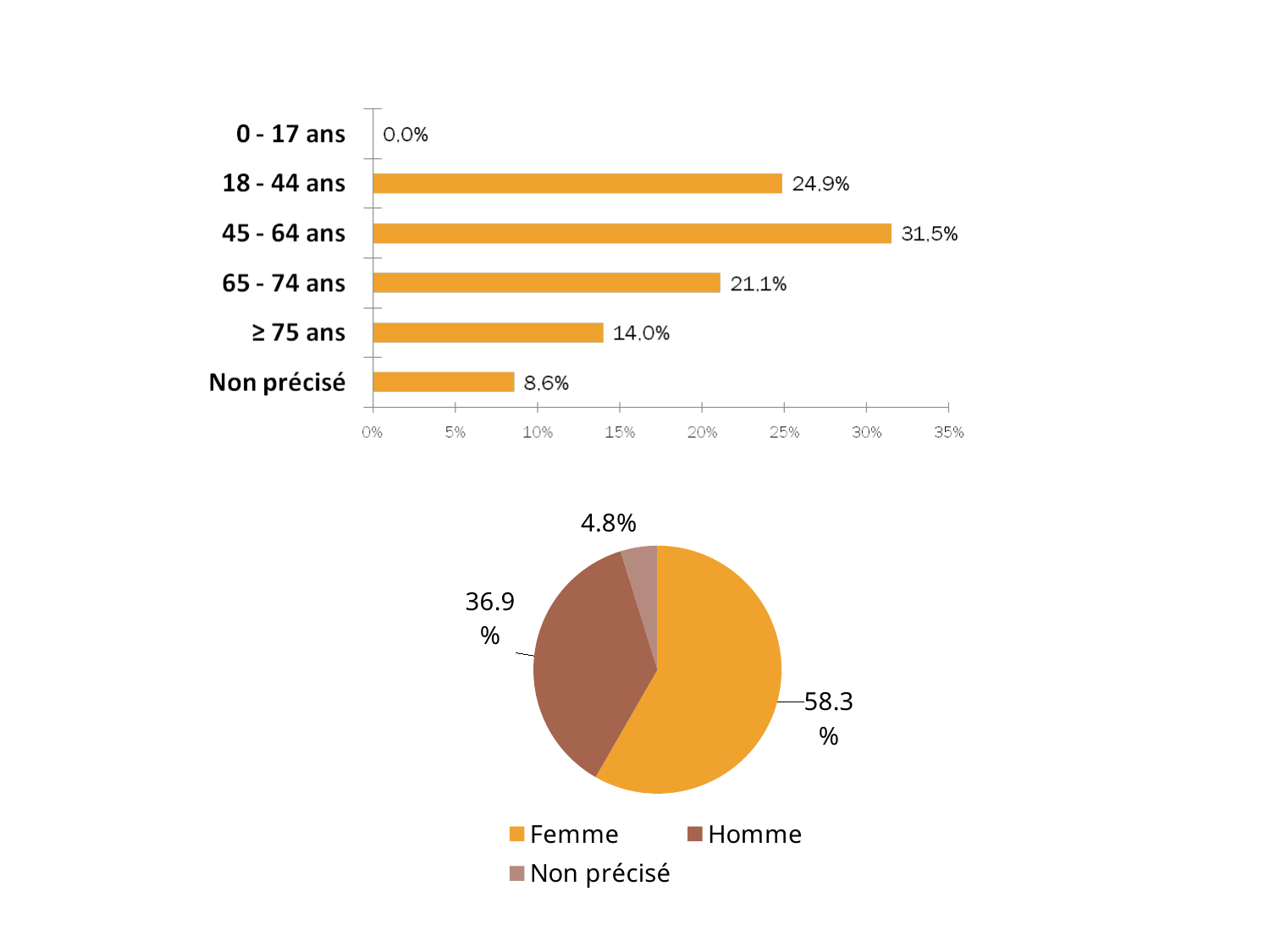
What kind of chart is the top chart on the slide? Bar chart In the top bar chart, what is the value for 45 - 64 ans? 31.5% In the bottom pie chart, what share does Homme have? 36.9% In the bottom pie chart, what share does Femme have? 58.3% In the bottom pie chart, which slice is the smallest? Non précisé In the top bar chart, what is the difference between the values for 18 - 44 ans and 65 - 74 ans? 3.8% In the top bar chart, which is larger: the value for 65 - 74 ans or the value for Non précisé? 65 - 74 ans How many entries does the legend of the bottom pie chart list? 3 In the top bar chart, which category has the lowest value? 0 - 17 ans In the top bar chart, which age category has the highest value? 45 - 64 ans In the top bar chart, what is the value for ≥ 75 ans? 14.0% In the top bar chart, how many categories are shown? 6